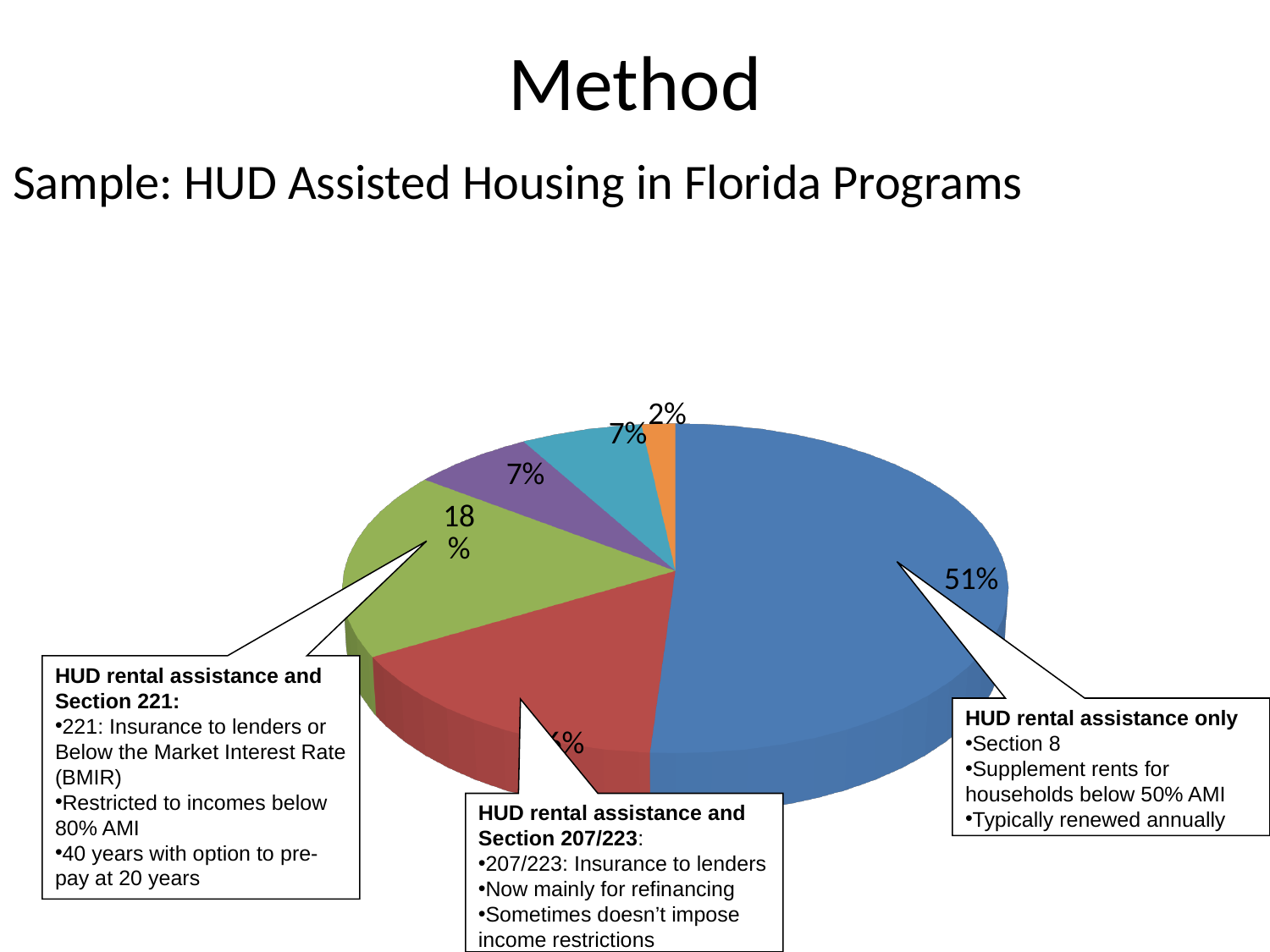
By how many percentage points does the HUD rental assistance only slice exceed the HUD rental assistance and Section 221 slice? 33 percentage points Which category has the largest slice of the pie? HUD rental assistance only What share of the pie is labelled for HUD rental assistance and Section 221? 18% What share of the pie is labelled for HUD rental assistance only? 51% What colour is the slice for HUD rental assistance and Section 221? green What kind of chart is shown on the slide? pie chart How many slices does the pie chart have? 6 Is the share for HUD rental assistance only greater or less than 50%? greater Which is larger: the slice for HUD rental assistance only or the slice for HUD rental assistance and Section 221? HUD rental assistance only What is the smallest percentage printed on the pie chart? 2% What colour is the slice for HUD rental assistance only? blue